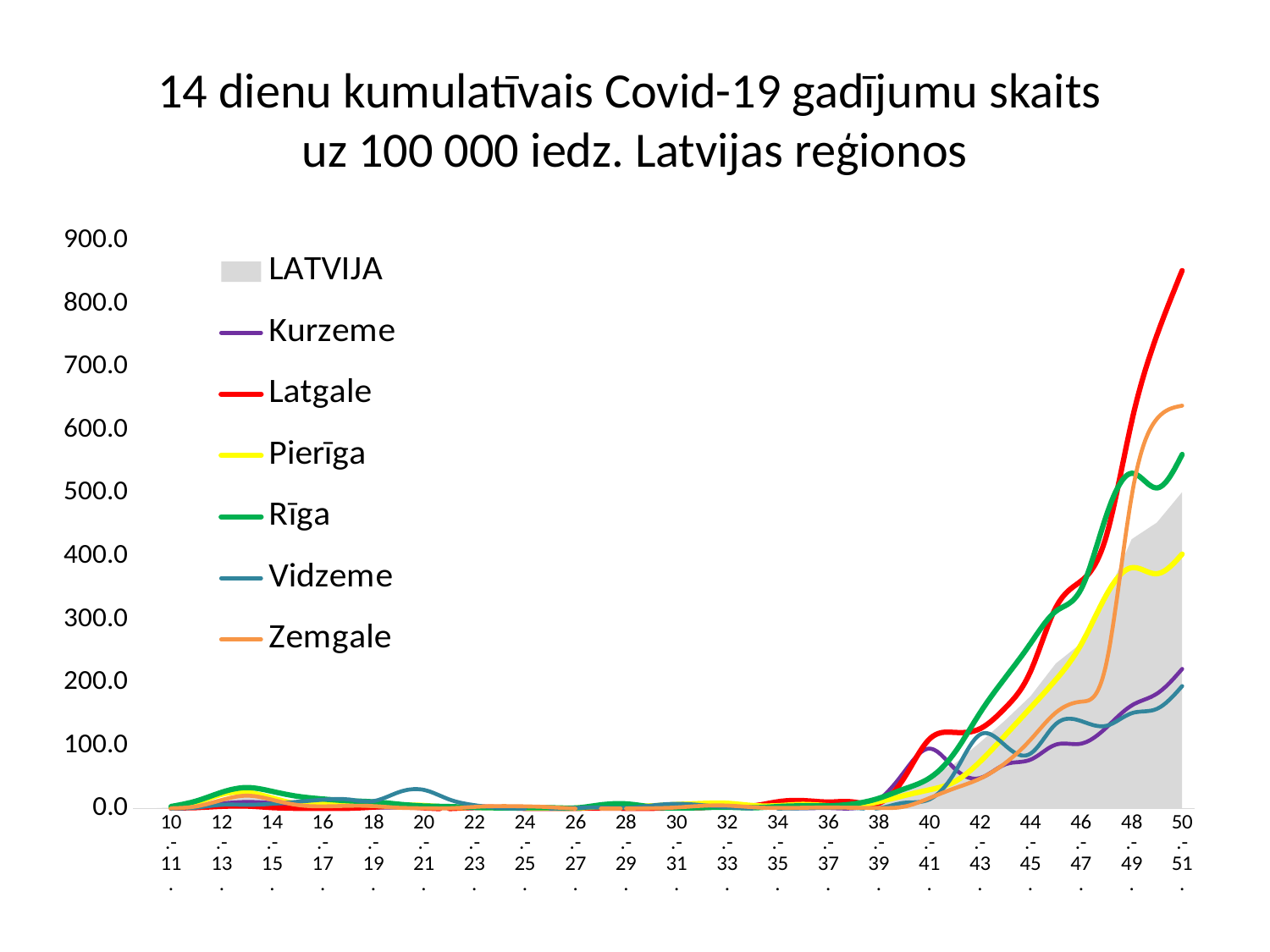
Which series is drawn as a shaded grey area rather than a line? LATVIJA Is the value for Latgale at 50.-51. greater or less than 800? greater Is the value for Kurzeme at 50.-51. greater or less than 100? greater Which region has the highest value at the last point (50.-51.)? Latgale How many series does the legend list? 7 Is the value for Zemgale at 50.-51. greater or less than 600? greater What kind of chart is shown on the slide? combination area and line chart (lines with a shaded area) At 50.-51., which is larger: the value for Latgale or the value for Pierīga? Latgale Does the Latgale line rise or fall overall from 38.-39. to 50.-51.? rise How many week-pair categories are shown on the x axis? 21